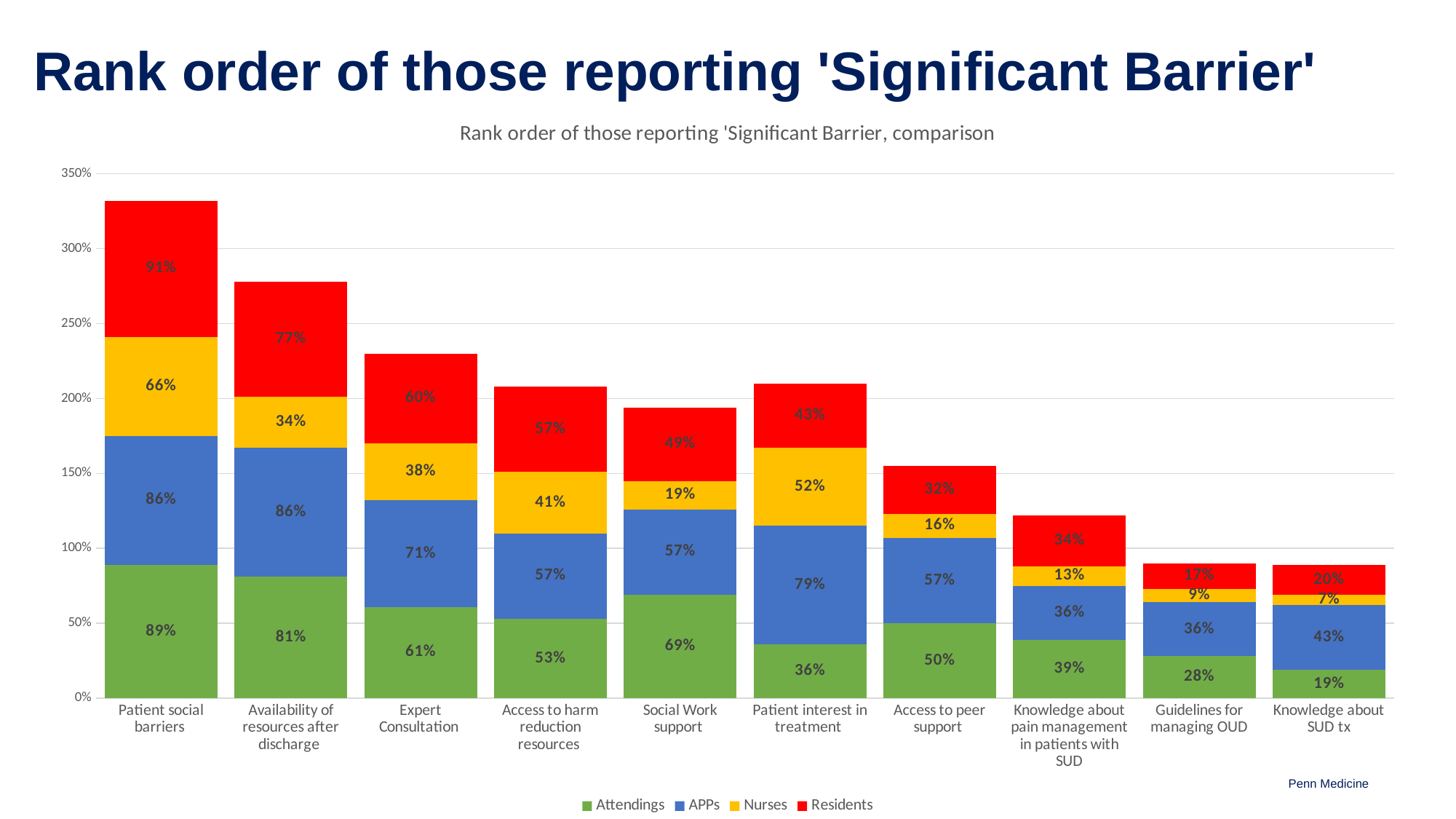
What is the Nurses value for 'Expert Consultation'? 38% Which category has the lowest Nurses value? Knowledge about SUD tx What is the Attendings value for 'Knowledge about SUD tx'? 19% What percentage of Residents reported 'Patient social barriers' as a significant barrier? 91% How many categories are shown on the x axis? 10 What is the APPs value for 'Patient interest in treatment'? 79% What is the difference between the Residents value and the Nurses value for 'Availability of resources after discharge'? 43% What type of chart is shown on the slide? Stacked bar chart What is the total of the stacked bar for 'Patient social barriers'? 332% Which category has the highest Attendings value? Patient social barriers How many series does the legend list? 4 For 'Social Work support', which is larger: the Attendings value or the APPs value? Attendings